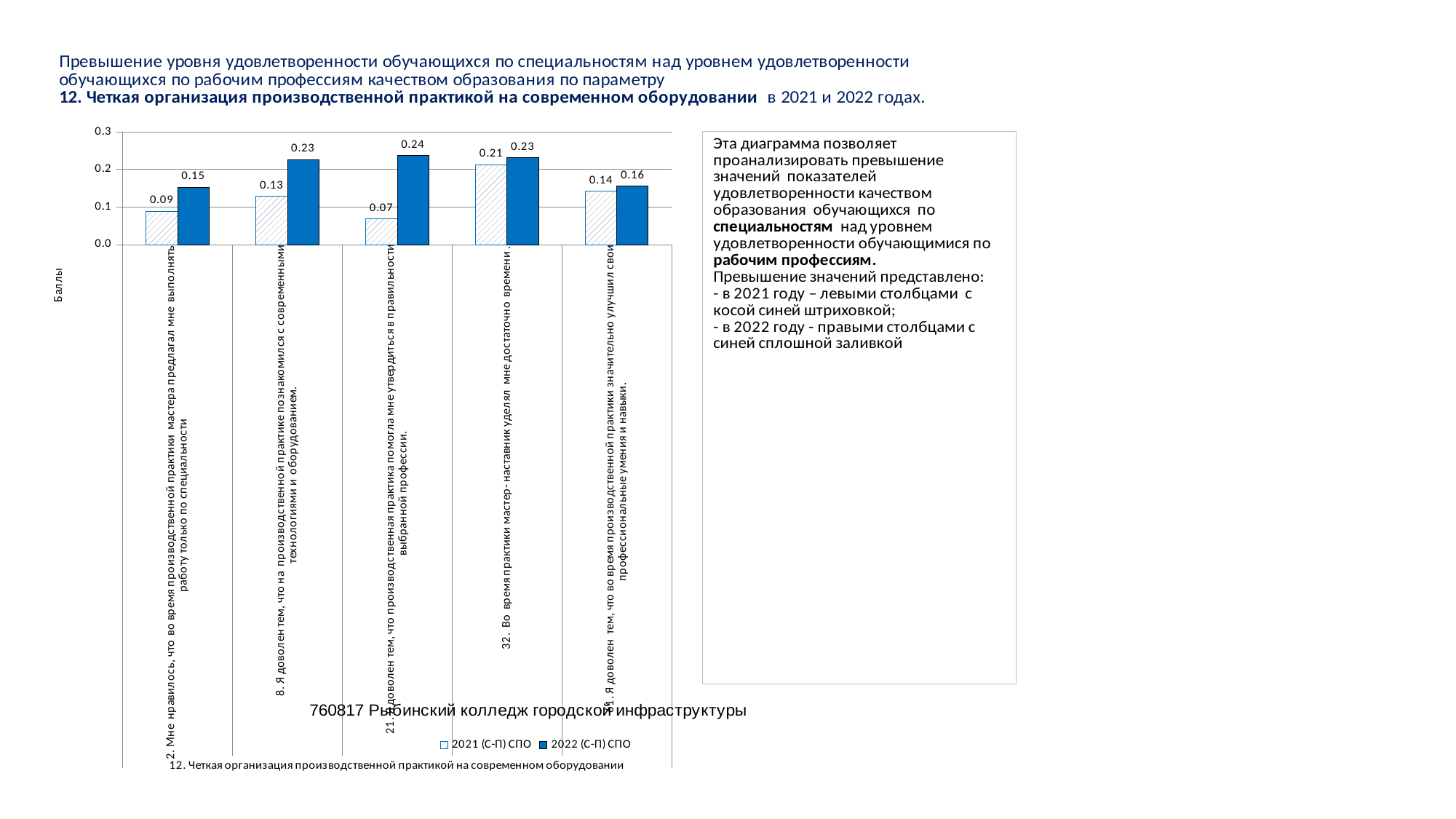
Which statement has the lowest 2021 (С-П) СПО value? 21. Я доволен тем, что производственная практика помогла мне утвердиться в правильности выбранной профессии What is the 2022 (С-П) СПО value for statement 8 ("Я доволен тем, что на производственной практике познакомился с современными технологиями и оборудованием")? 0.23 How many series does the chart legend list? 2 What is the 2022 (С-П) СПО value for the statement about significantly improving professional skills during practical training ("значительно улучшил свои профессиональные умения и навыки")? 0.16 What is the difference between the 2022 and 2021 (С-П) СПО values for statement 21? 0.17 What is the 2021 (С-П) СПО value for statement 21 ("Я доволен тем, что производственная практика помогла мне утвердиться в правильности выбранной профессии")? 0.07 According to the legend, which series is shown with solid blue fill? 2022 (С-П) СПО What type of chart is shown on the slide? bar chart What is the 2021 (С-П) СПО value for statement 2 ("Мне нравилось, что во время производственной практики мастера предлагал мне выполнять работу только по специальности")? 0.09 Which is larger for statement 32 ("Во время практики мастер-наставник уделял мне достаточно времени"): the 2021 (С-П) СПО value or the 2022 (С-П) СПО value? 2022 (С-П) СПО Which statement has the highest 2022 (С-П) СПО value? 21. Я доволен тем, что производственная практика помогла мне утвердиться в правильности выбранной профессии How many categories (survey statements) are plotted on the chart? 5